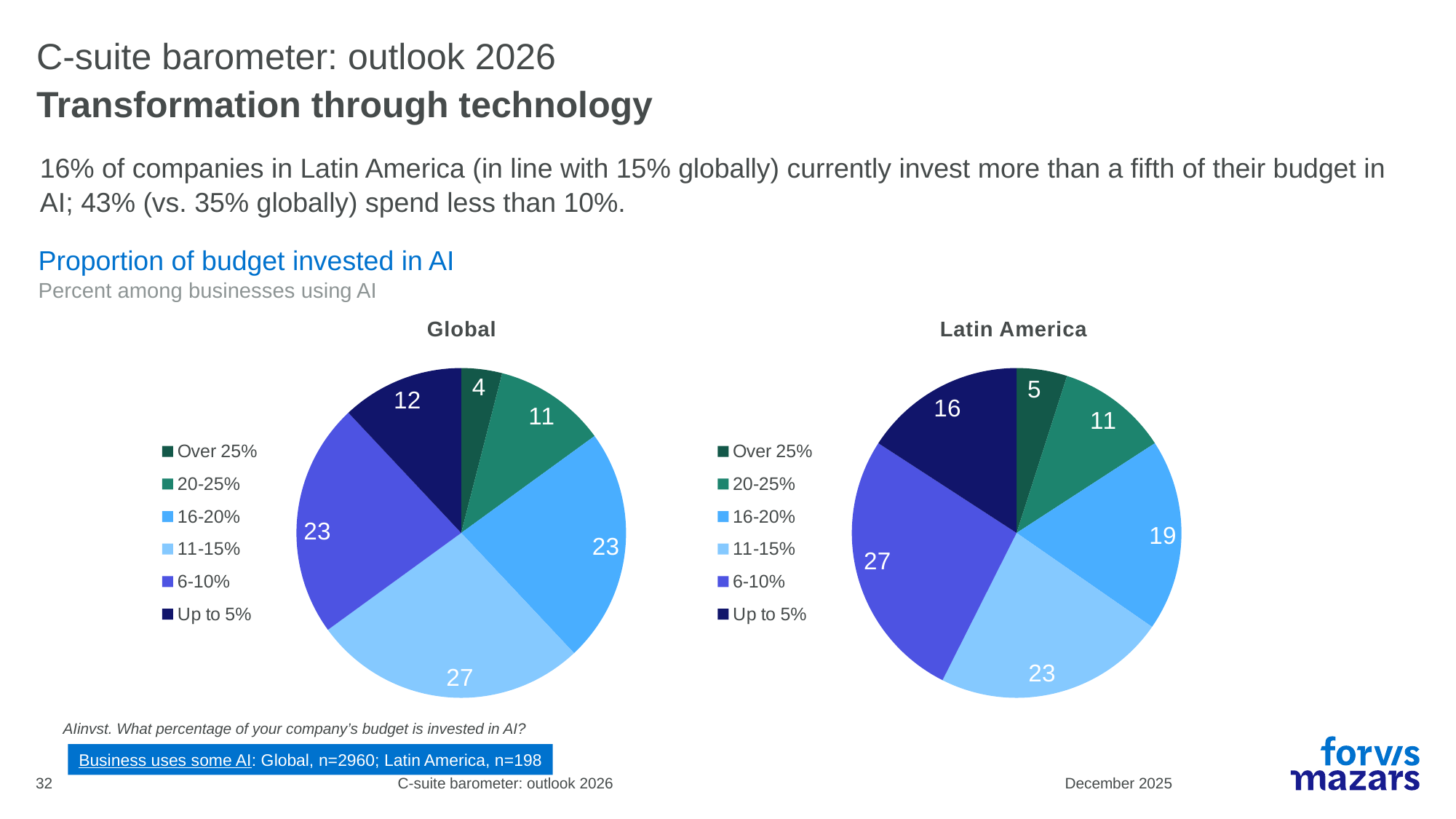
What type of chart is used to show the Latin America data? Pie chart Which is larger: the 16-20% value in the Global pie chart or in the Latin America pie chart? Global In the Global pie chart, which category has the largest slice? 11-15% In the Latin America pie chart, what is the value for the 6-10% category? 27 How many categories does the legend of the Global pie chart list? 6 In the Latin America pie chart, what is the value for the Up to 5% category? 16 In the Global pie chart, what is the value for the Over 25% category? 4 What is the title shown above the two pie charts? Proportion of budget invested in AI What is the difference between the Up to 5% values in the Latin America and Global pie charts? 4 In the Latin America pie chart, which category has the smallest slice? Over 25% In the Latin America pie chart, which category has the largest slice? 6-10% In the Global pie chart, what is the value for the 11-15% category? 27